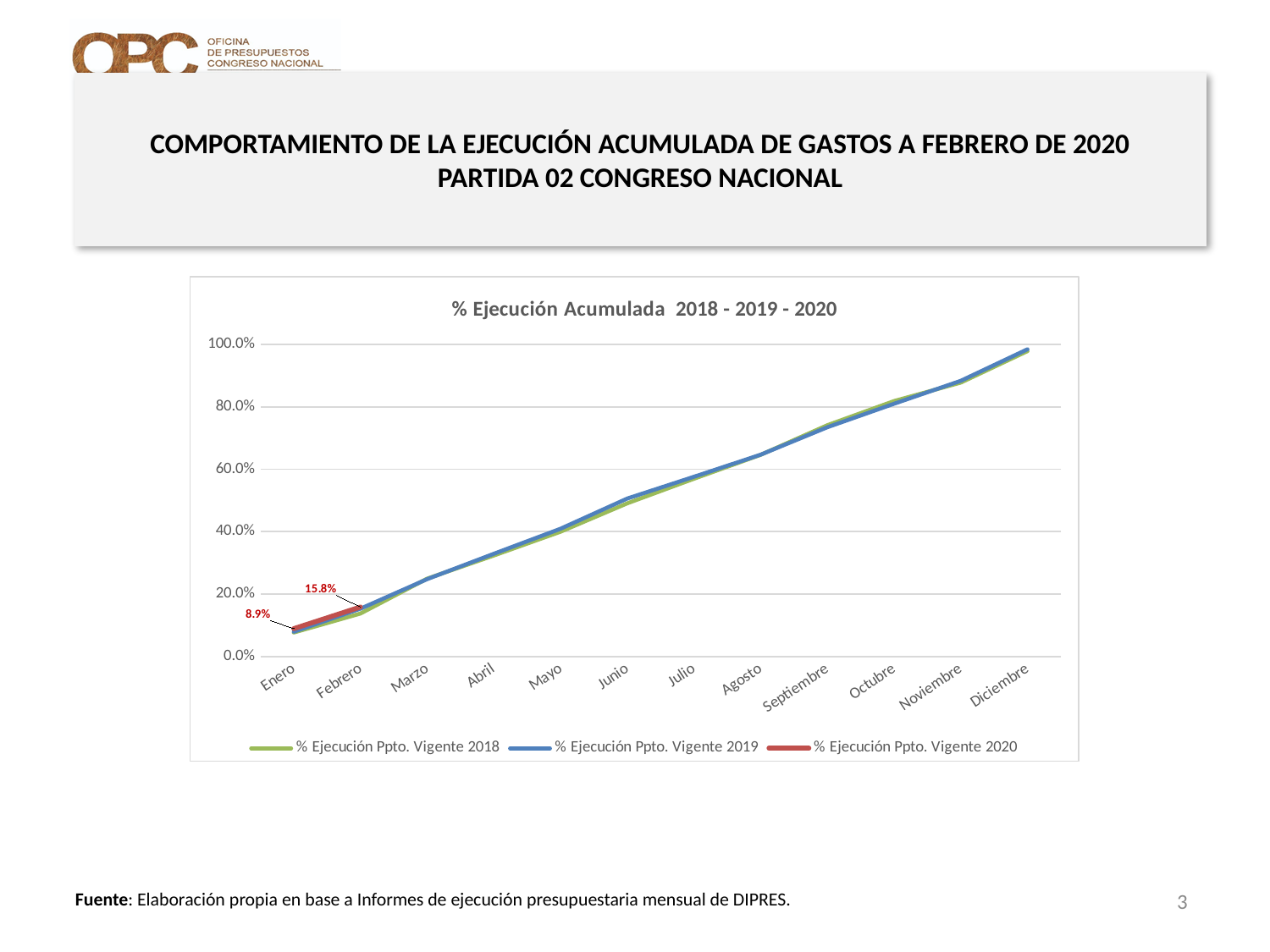
What is the difference between the Febrero and Enero values of the % Ejecución Ppto. Vigente 2020 series? 6.9% Which is larger in the 2020 series, the value for Enero or the value for Febrero? Febrero Which series is drawn in red? % Ejecución Ppto. Vigente 2020 Is the value for Marzo in the % Ejecución Ppto. Vigente 2018 series greater or less than 40.0%? less Do the values of the % Ejecución Ppto. Vigente 2019 series rise or fall from Enero to Diciembre? Rise How many series does the legend list? 3 What is the value for Febrero in the % Ejecución Ppto. Vigente 2020 series? 15.8% Is the value for Diciembre in the % Ejecución Ppto. Vigente 2019 series greater or less than 80.0%? greater What kind of chart is shown on the slide? Line chart What is the title of the chart? % Ejecución Acumulada 2018 - 2019 - 2020 How many months are shown on the x axis? 12 What is the value for Enero in the % Ejecución Ppto. Vigente 2020 series? 8.9%